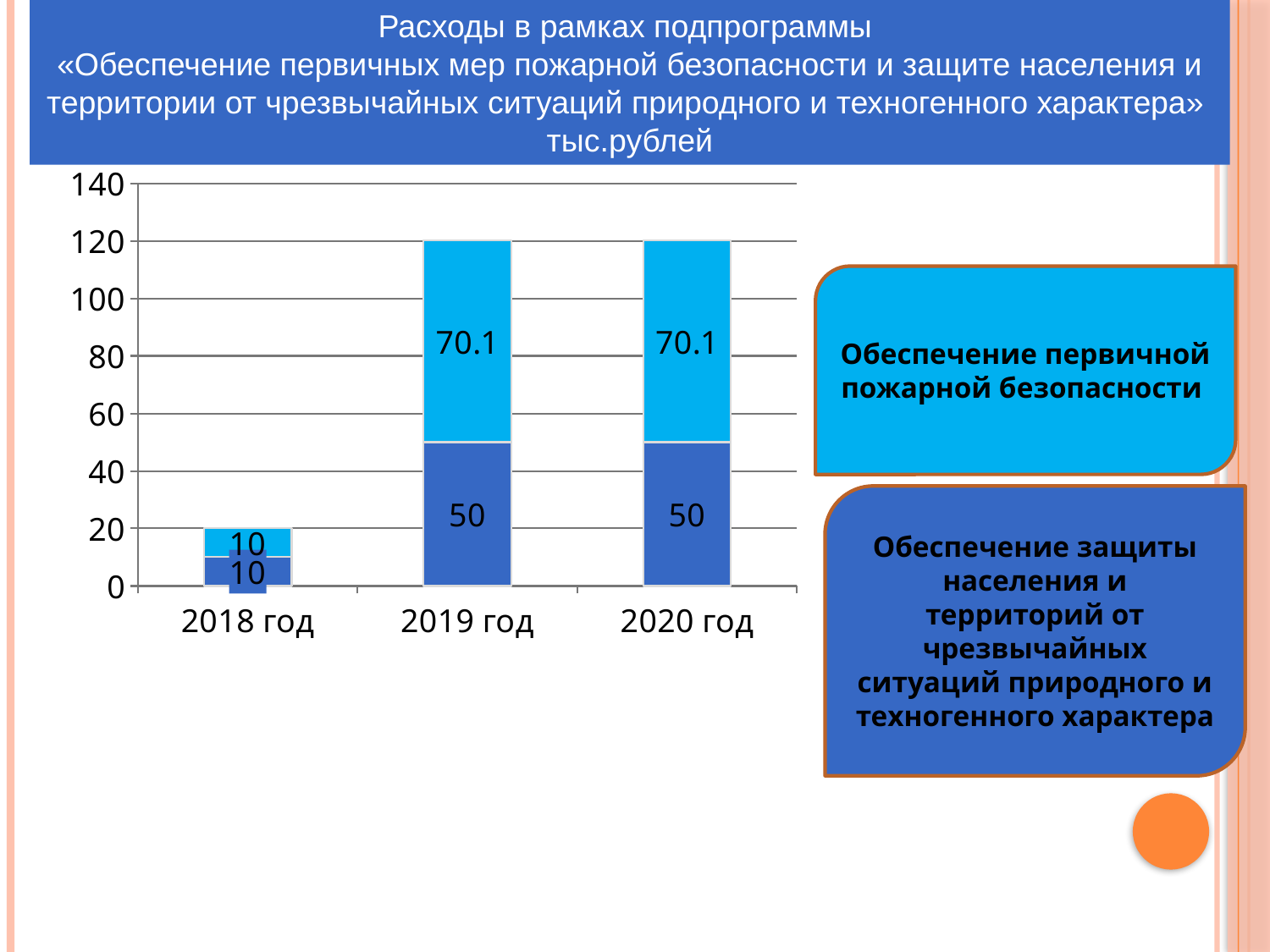
What is the value for 'Обеспечение защиты населения и территорий от чрезвычайных ситуаций' (dark blue) in 2020 год? 50 What is the value for the dark blue series in 2018 год? 10 What kind of chart is shown on the slide? stacked bar chart How many years (categories) are shown on the x axis of the chart? 3 What is the value for 'Обеспечение первичной пожарной безопасности' (light blue) in 2019 год? 70.1 What is the total of the stacked bar for 2018 год? 20 What is the difference between the light blue value and the dark blue value in 2020 год? 20.1 Is the total for 2020 год greater or less than 100? greater Which is larger in 2019 год: the light blue segment or the dark blue segment? light blue (70.1) What is the total of the stacked bar for 2019 год? 120.1 Which year has the lowest total expenses in the chart? 2018 год How many series (expense types) does the chart show, according to the labelled boxes beside it? 2